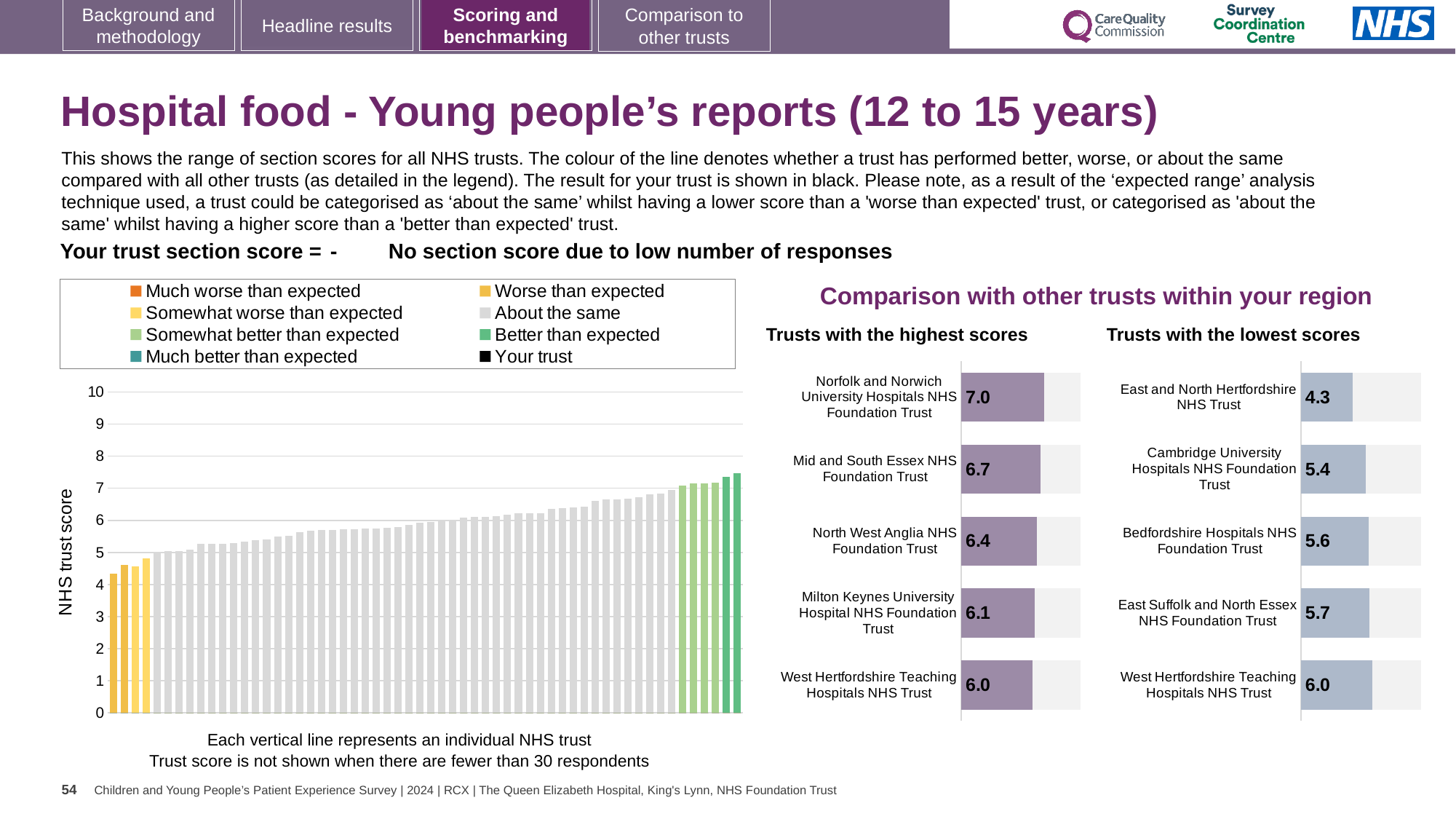
In the 'Trusts with the highest scores' chart, what is the difference between the scores of Norfolk and Norwich University Hospitals NHS Foundation Trust and Mid and South Essex NHS Foundation Trust? 0.3 In the 'Trusts with the lowest scores' chart, what is the difference between the scores of Bedfordshire Hospitals NHS Foundation Trust and East and North Hertfordshire NHS Trust? 1.3 In the 'Trusts with the lowest scores' chart, which has the larger score: Cambridge University Hospitals NHS Foundation Trust or East Suffolk and North Essex NHS Foundation Trust? East Suffolk and North Essex NHS Foundation Trust In the 'Trusts with the highest scores' chart, which trust has the highest score? Norfolk and Norwich University Hospitals NHS Foundation Trust How many trusts are shown in the 'Trusts with the highest scores' chart? 5 In the 'NHS trust score' chart on the left, is the value of the leftmost bar greater or less than 5? less In the 'NHS trust score' chart on the left, do the bar values rise or fall from left to right? Rise What kind of chart is the large 'NHS trust score' chart on the left of the slide? Bar chart In the 'Trusts with the lowest scores' chart, what is the score for East and North Hertfordshire NHS Trust? 4.3 In the 'Trusts with the lowest scores' chart, which trust has the lowest score? East and North Hertfordshire NHS Trust In the 'Trusts with the highest scores' chart, what is the score for North West Anglia NHS Foundation Trust? 6.4 In the 'Trusts with the highest scores' chart, what is the score for Norfolk and Norwich University Hospitals NHS Foundation Trust? 7.0